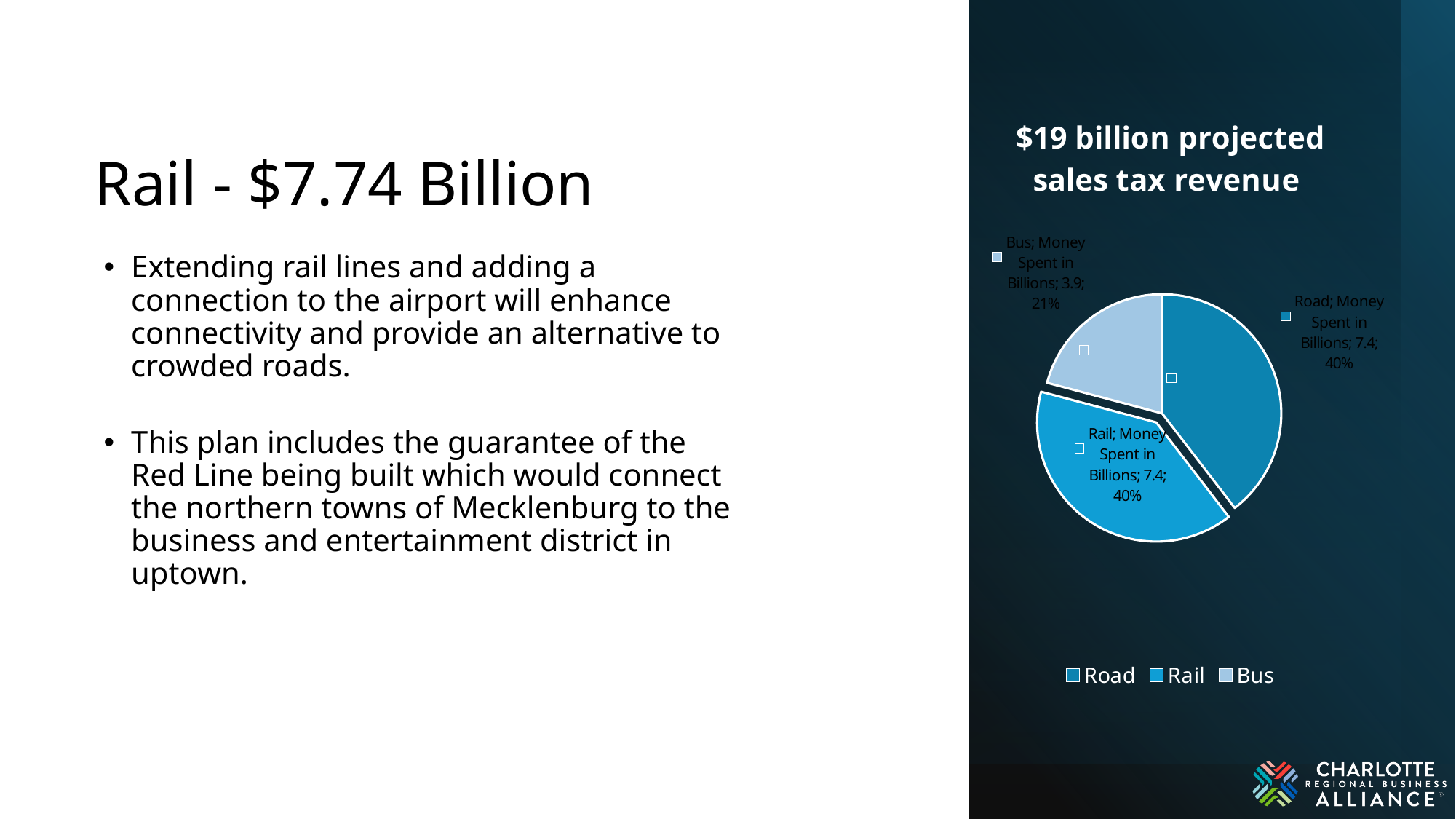
Which is larger, the value for Rail or the value for Bus? Rail How many entries does the chart legend list? 3 What share of the pie does Road represent? 40% What share of the pie does Bus represent? 21% What is the value (Money Spent in Billions) for Road? 7.4 What type of chart is shown on the slide? pie chart How many slices does the pie chart have? 3 What is the title of the chart? $19 billion projected sales tax revenue Which category has the smallest slice of the pie? Bus What is the value (Money Spent in Billions) for Bus? 3.9 What is the value (Money Spent in Billions) for Rail? 7.4 What is the difference between the Road value and the Bus value? 3.5